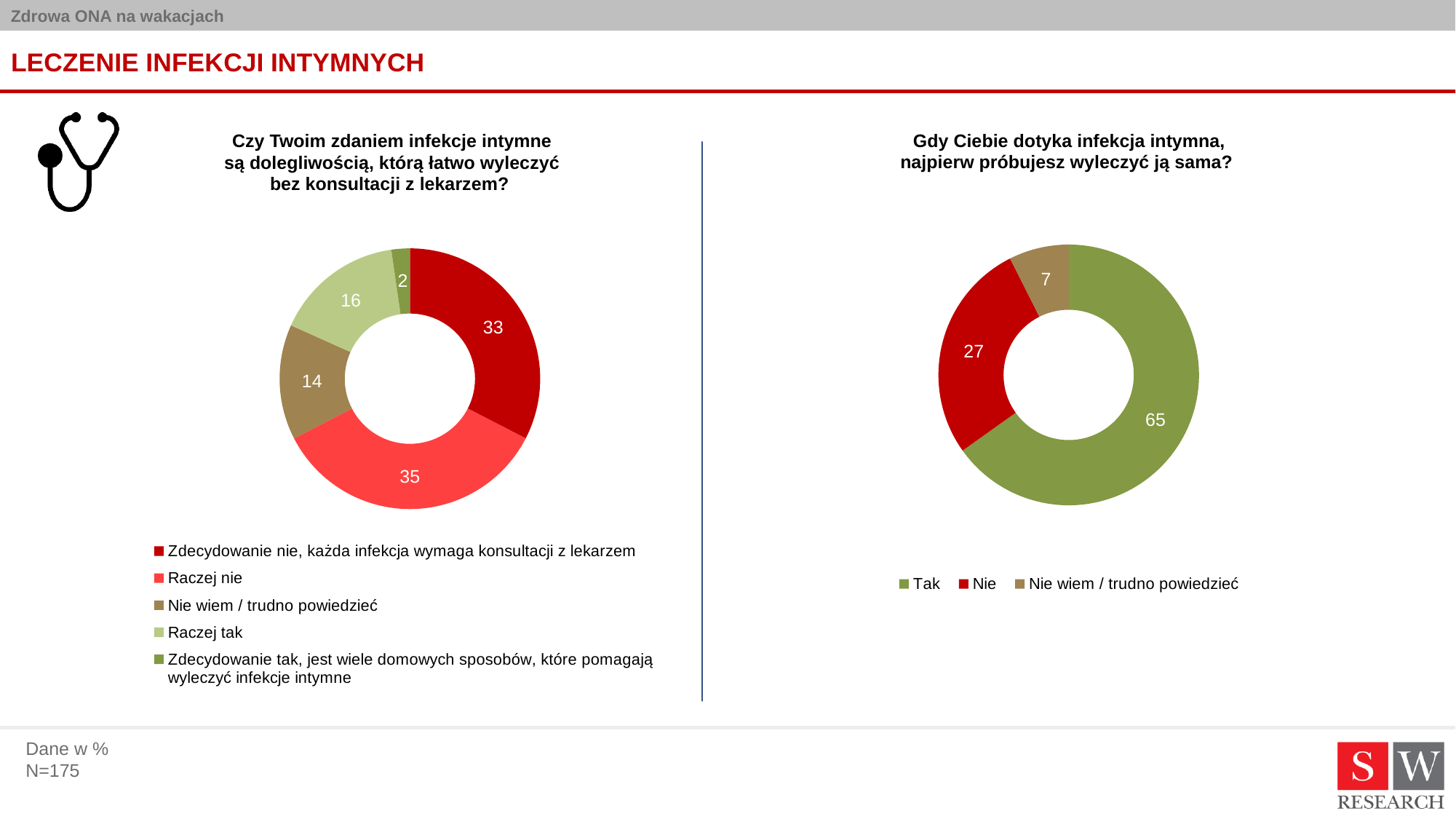
In the right chart ("Gdy Ciebie dotyka infekcja intymna, najpierw próbujesz wyleczyć ją sama?"), what is the value for "Tak"? 65 In the left chart ("Czy Twoim zdaniem infekcje intymne..."), what is the value for "Raczej tak"? 16 In the right chart ("Gdy Ciebie dotyka infekcja intymna..."), which category has the largest value? Tak In the left chart ("Czy Twoim zdaniem infekcje intymne..."), how many categories does the legend list? 5 In the left chart ("Czy Twoim zdaniem infekcje intymne..."), what is the value for "Zdecydowanie nie, każda infekcja wymaga konsultacji z lekarzem"? 33 In the left chart ("Czy Twoim zdaniem infekcje intymne są dolegliwością, którą łatwo wyleczyć bez konsultacji z lekarzem?"), what is the value for "Raczej nie"? 35 In the left chart ("Czy Twoim zdaniem infekcje intymne..."), which category has the smallest value? Zdecydowanie tak, jest wiele domowych sposobów, które pomagają wyleczyć infekcje intymne In the left chart ("Czy Twoim zdaniem infekcje intymne..."), what is the difference between "Raczej tak" and "Nie wiem / trudno powiedzieć"? 2 In the right chart ("Gdy Ciebie dotyka infekcja intymna..."), which is larger: "Nie" or "Nie wiem / trudno powiedzieć"? Nie What type of chart is used on the right side of the slide ("Gdy Ciebie dotyka infekcja intymna...")? Donut (pie) chart In the right chart ("Gdy Ciebie dotyka infekcja intymna..."), what is the difference between "Tak" and "Nie"? 38 In the right chart ("Gdy Ciebie dotyka infekcja intymna..."), what is the value for "Nie wiem / trudno powiedzieć"? 7